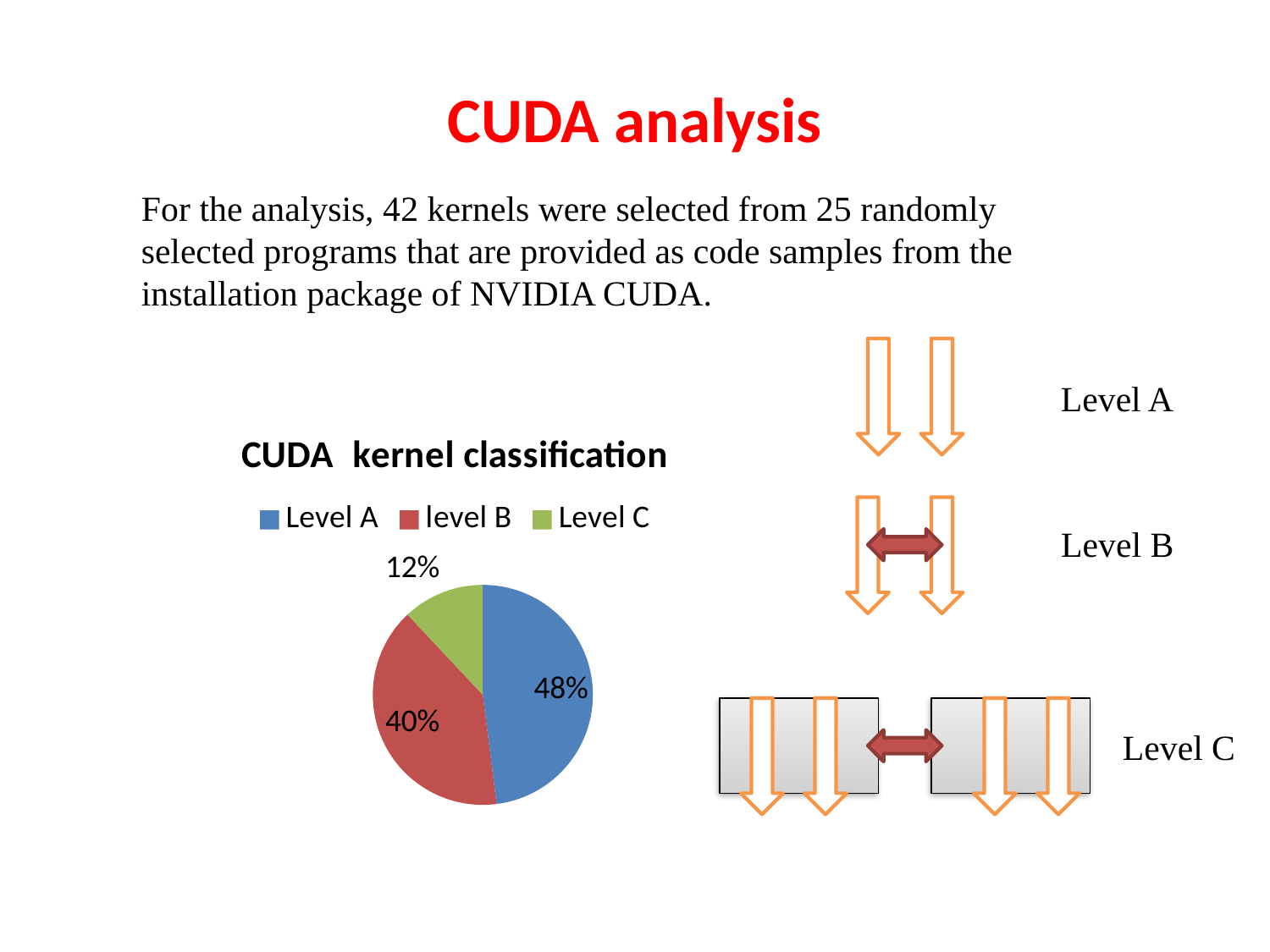
Which level has the largest slice of the pie? Level A Which level has the smallest slice of the pie? Level C Which is larger, the share for level B or the share for Level C? level B What share of the pie does Level C have? 12% What is the difference in percentage points between Level A and level B? 8% What is the title of the pie chart? CUDA kernel classification What kind of chart is shown on the slide? pie chart What is the difference in percentage points between level B and Level C? 28% What colour is the Level C slice in the pie chart? green What share of the pie does Level A have? 48% What share of the pie does level B have? 40% How many categories does the pie chart have? 3